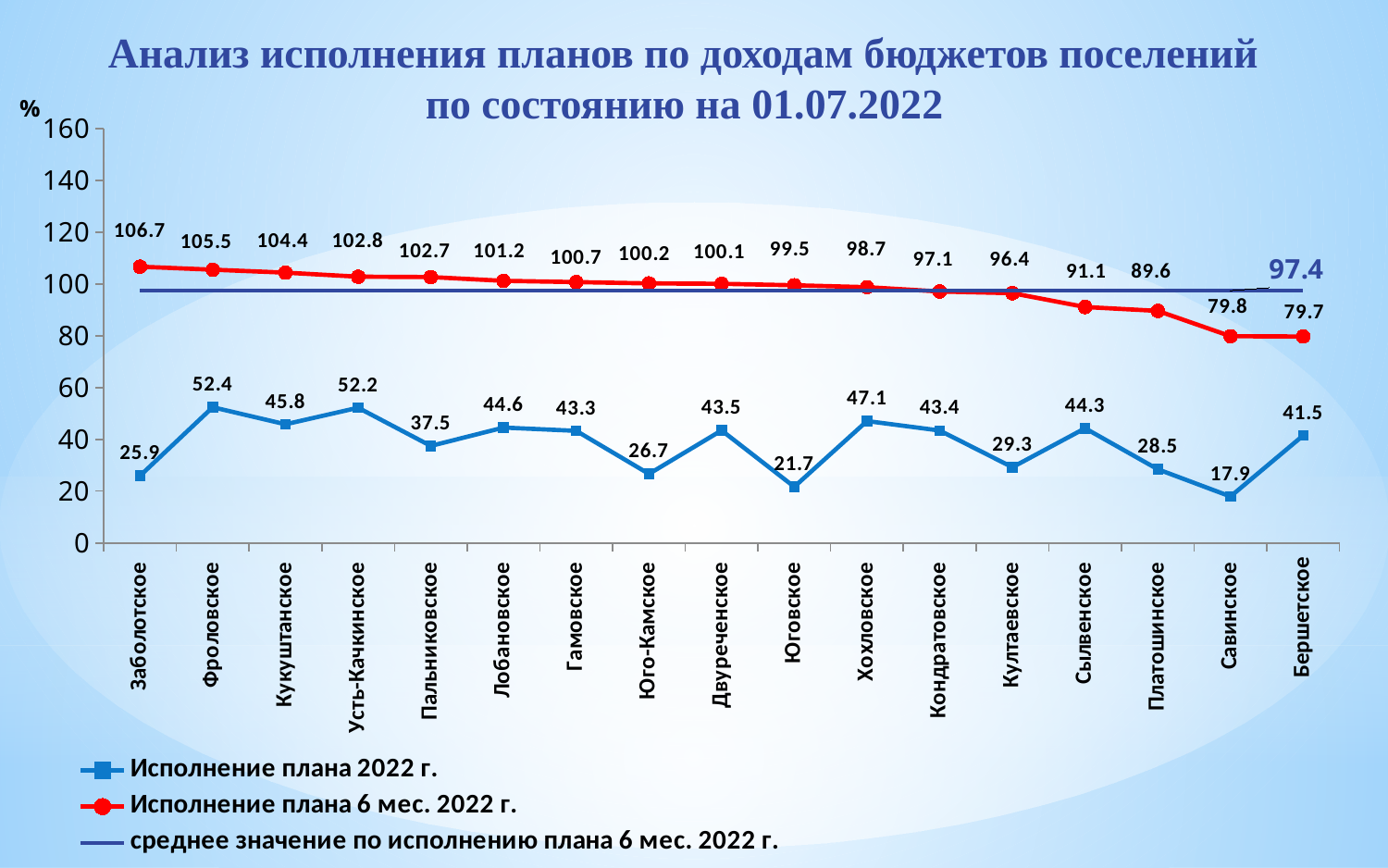
What colour is the line for 'Исполнение плана 2022 г.'? blue What type of chart is shown on the slide? line chart What is the difference between the 'Исполнение плана 6 мес. 2022 г.' values for Заболотское and Бершетское? 27.0 Which is larger for Хохловское: 'Исполнение плана 2022 г.' or 'Исполнение плана 6 мес. 2022 г.'? Исполнение плана 6 мес. 2022 г. What is the value of 'Исполнение плана 2022 г.' for Савинское? 17.9 Does the 'Исполнение плана 6 мес. 2022 г.' series generally rise or fall from left to right along the x axis? fall What is the value of 'Исполнение плана 6 мес. 2022 г.' for Заболотское? 106.7 Which settlement has the highest value for 'Исполнение плана 2022 г.'? Фроловское How many settlements are plotted along the x axis? 17 Which settlement has the lowest value for 'Исполнение плана 6 мес. 2022 г.'? Бершетское What is the value of the average line 'среднее значение по исполнению плана 6 мес. 2022 г.'? 97.4 How many series does the legend list? 3